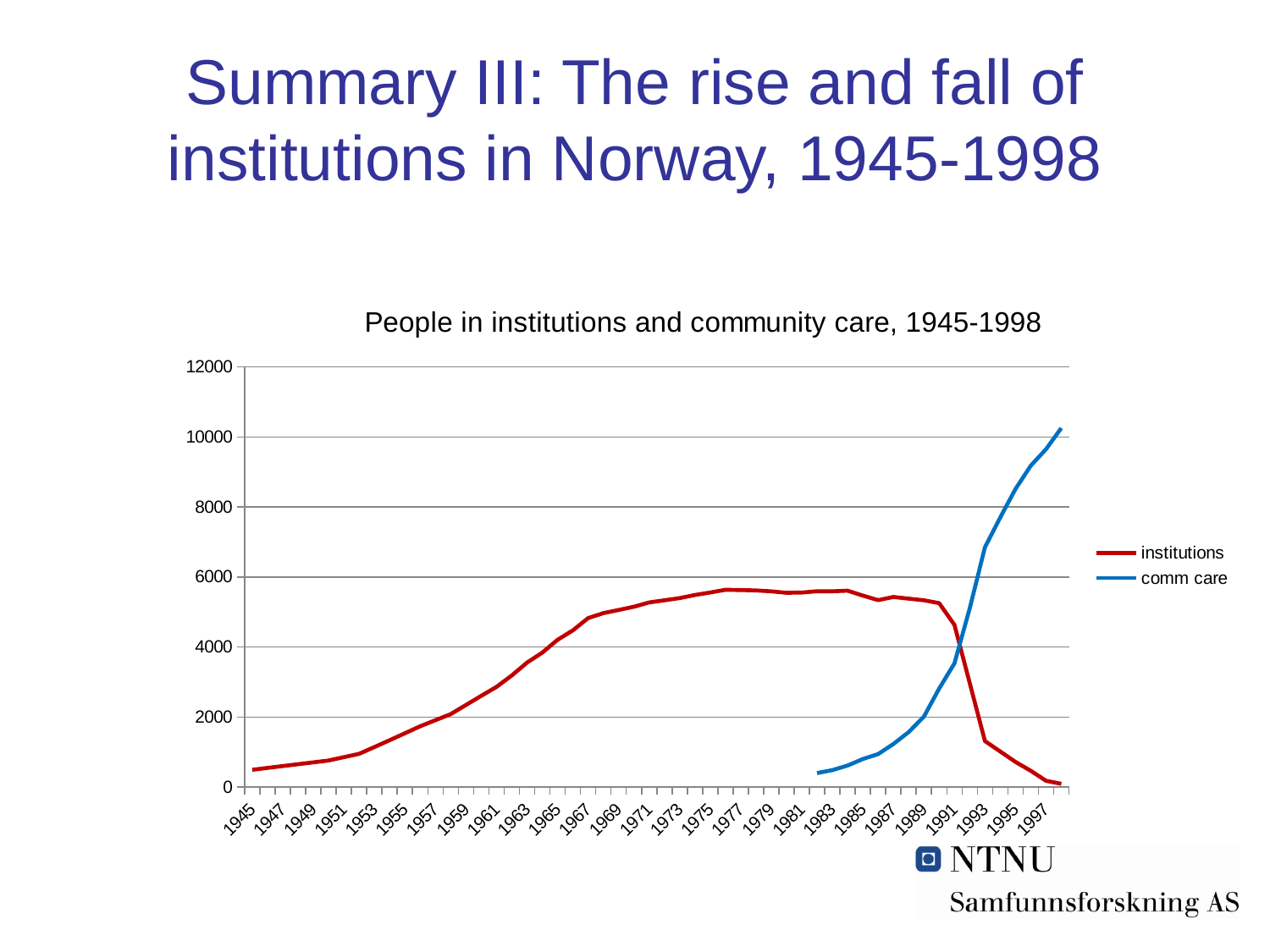
Is the value for comm care in 1997 greater or less than 8000? greater In 1997, which series has the larger value, institutions or comm care? comm care In 1985, which series has the larger value, institutions or comm care? institutions What are the two series named in the legend? institutions and comm care What is the title of the chart? People in institutions and community care, 1945-1998 Is the value for institutions in 1977 greater or less than 6000? less What kind of chart is shown on the slide? line chart Is the value for institutions in 1997 greater or less than 2000? less Does the institutions line rise or fall between 1991 and 1998? fall How many series does the legend list? 2